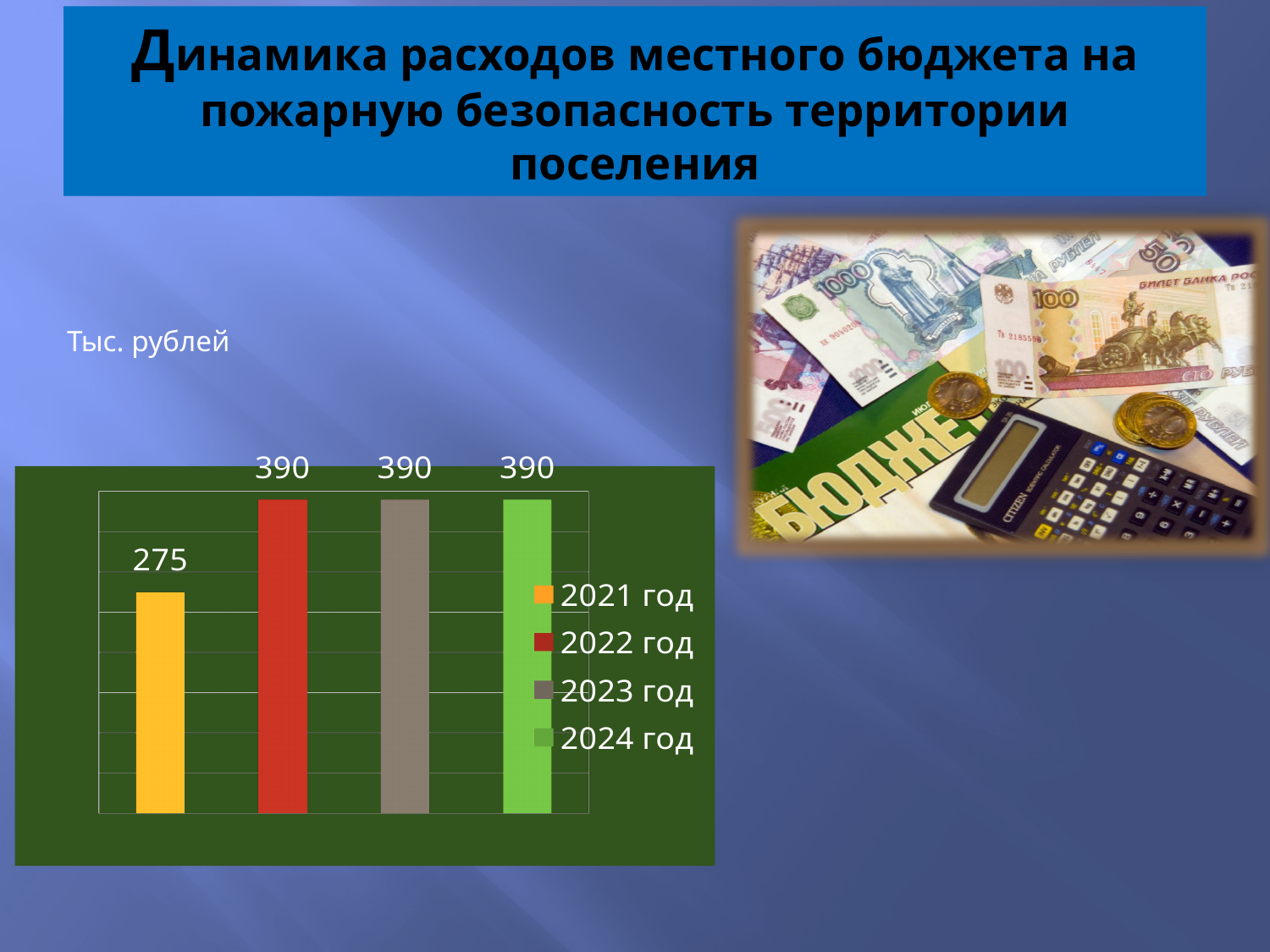
What is the value for 2022 год? 390 What kind of chart is shown on the slide? Bar chart What is the value for 2024 год? 390 Which year has the lowest value? 2021 год Do the values rise or fall from 2021 год to 2022 год? Rise What colour is the bar for 2021 год? Yellow Which is larger, the value for 2021 год or the value for 2023 год? 2023 год What is the value for 2021 год? 275 How many entries does the legend list? 4 What unit is stated for the chart values? Тыс. рублей How many bars are plotted in the chart? 4 What is the difference between the values for 2022 год and 2021 год? 115